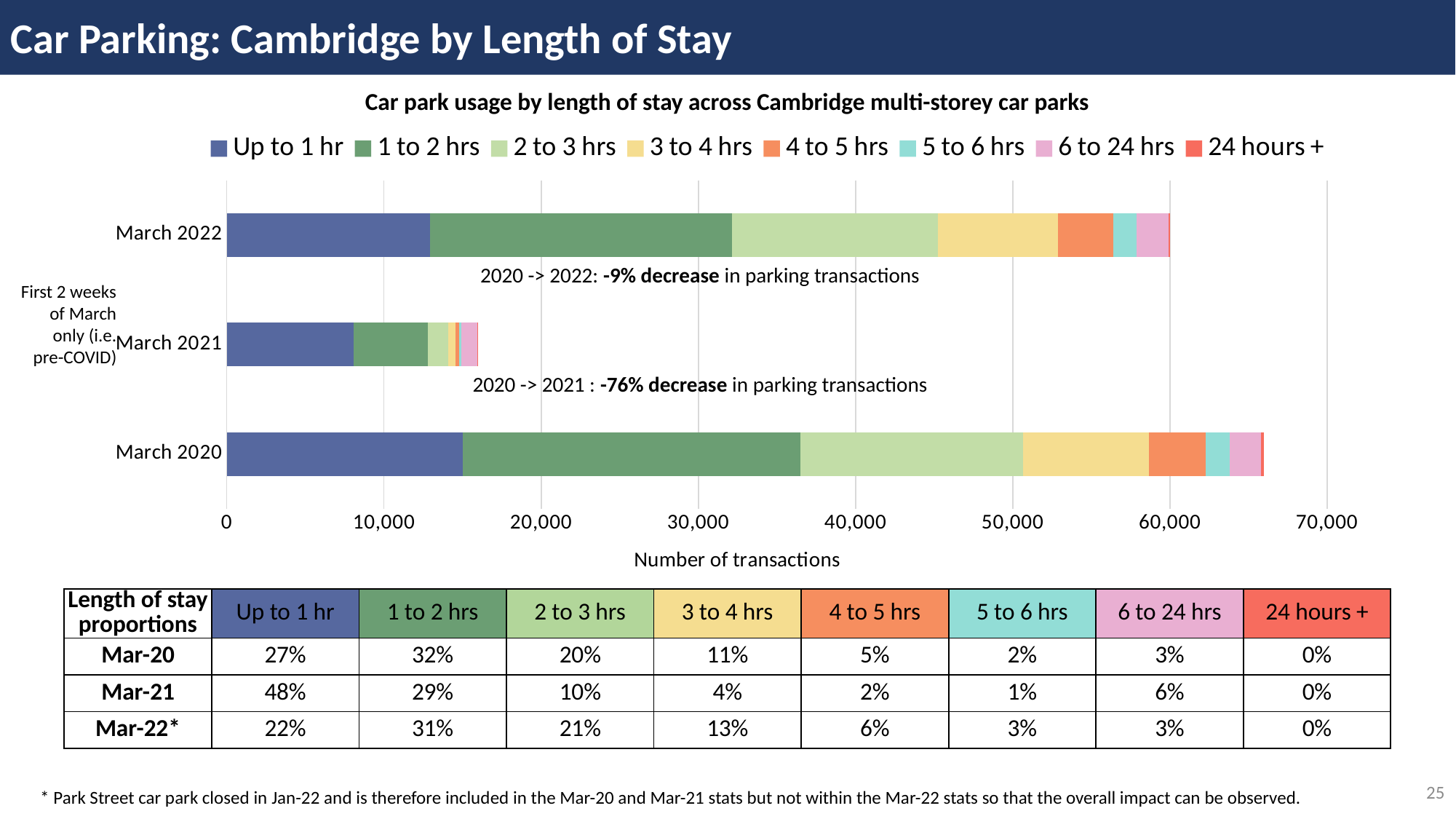
How many series does the chart legend list? 8 Is the total number of transactions for March 2022 greater or less than 50,000? greater Is the total number of transactions for March 2020 greater or less than 60,000? greater What kind of chart is shown on the slide? Stacked bar chart What is the label on the horizontal axis of the chart? Number of transactions Is the 'Up to 1 hr' segment for March 2021 greater or less than 10,000 transactions? less How many time periods (bars) are plotted in the chart? 3 Which period has the lowest total number of transactions in the chart? March 2021 Which bar is longer in total: March 2021 or March 2022? March 2022 What is the title of the chart? Car park usage by length of stay across Cambridge multi-storey car parks Which period has the highest total number of transactions in the chart? March 2020